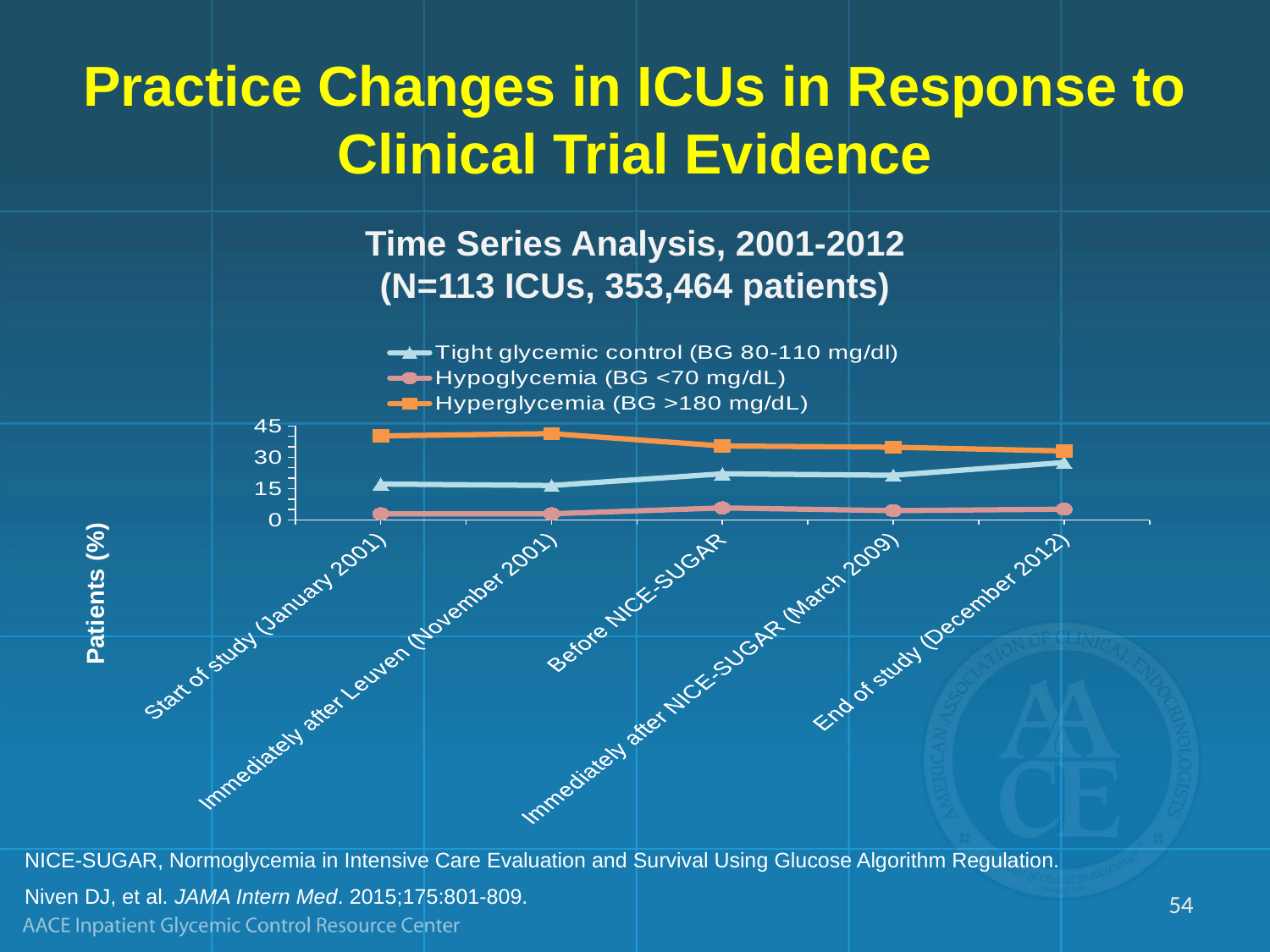
Does the Hyperglycemia (BG >180 mg/dL) line rise or fall from Start of study (January 2001) to End of study (December 2012)? Fall At End of study (December 2012), which series has the lowest value? Hypoglycemia (BG <70 mg/dL) How many time points are plotted along the x axis? 5 At Before NICE-SUGAR, which is larger: Hyperglycemia (BG >180 mg/dL) or Tight glycemic control (BG 80-110 mg/dl)? Hyperglycemia (BG >180 mg/dL) What is the label on the y axis of the chart? Patients (%) How many series does the legend list? 3 Is the value for Hypoglycemia (BG <70 mg/dL) at End of study (December 2012) greater or less than 15? less Is the value for Tight glycemic control (BG 80-110 mg/dl) at Start of study (January 2001) greater or less than 30? less At Start of study (January 2001), which series has the highest value? Hyperglycemia (BG >180 mg/dL) Is the value for Tight glycemic control (BG 80-110 mg/dl) at End of study (December 2012) greater or less than 15? greater What kind of chart is shown on the slide? Line chart